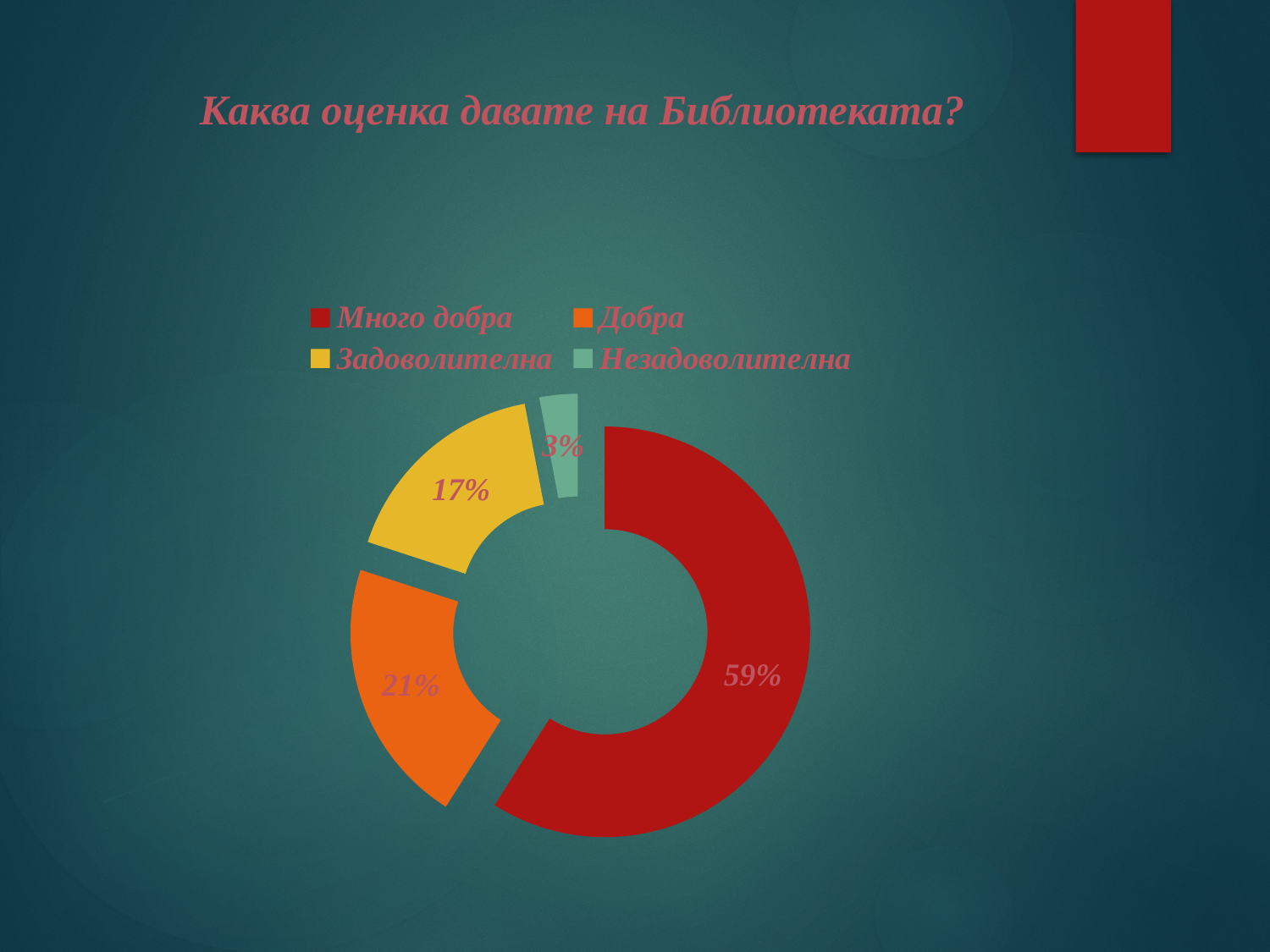
Which category has the largest share? Много добра What share of responses is 'Добра'? 21% What share of responses is 'Много добра'? 59% What is the difference in percentage points between 'Много добра' and 'Добра'? 38 What kind of chart is shown on the slide? Doughnut (pie) chart What is the title of the chart? Каква оценка давате на Библиотеката? Which category has the smallest share? Незадоволителна Which is larger, the share for 'Добра' or for 'Задоволителна'? Добра What share of responses is 'Незадоволителна'? 3% How many categories does the legend list? 4 What share of responses is 'Задоволителна'? 17% What colour is the slice for 'Задоволителна'? Yellow